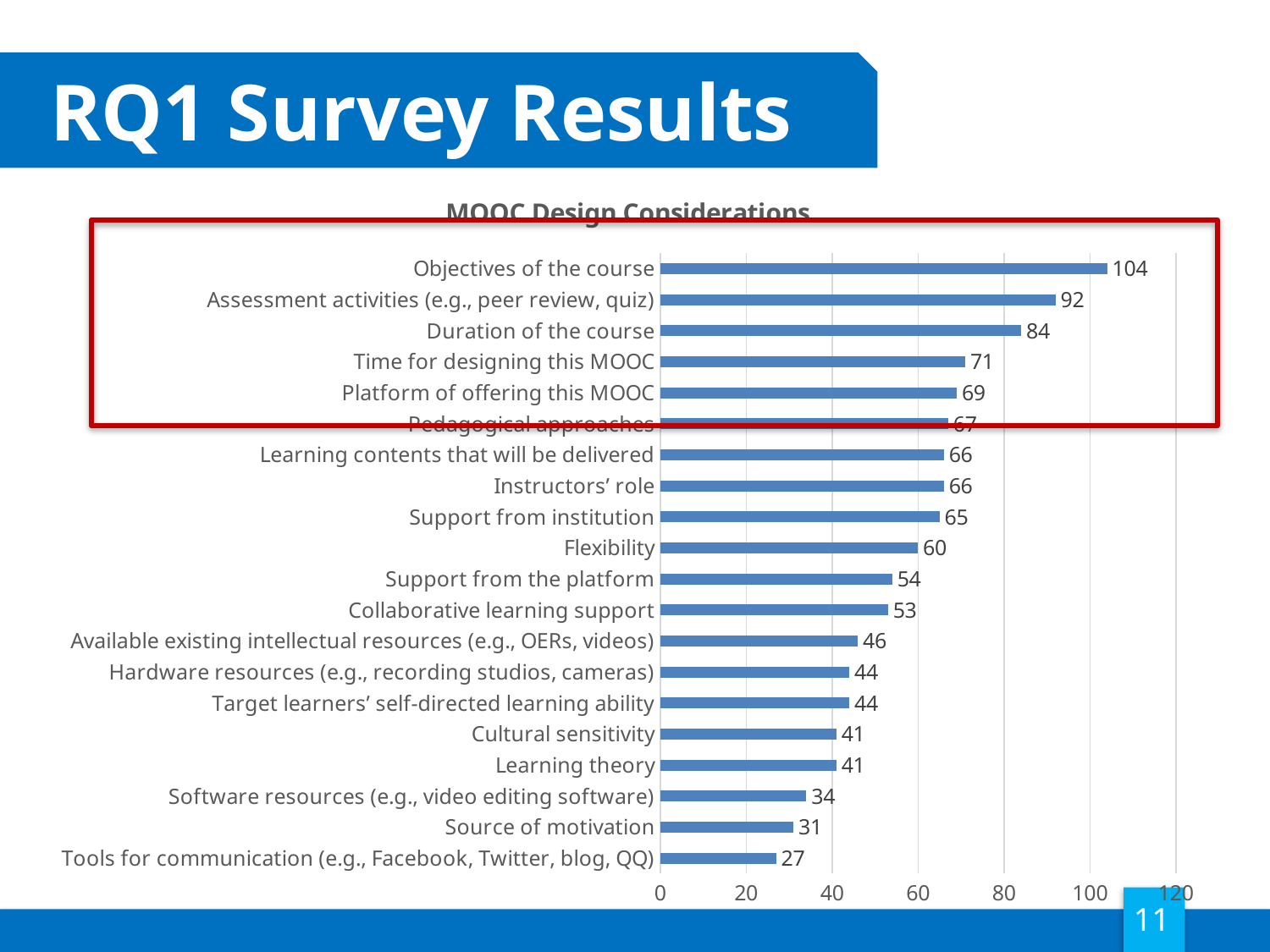
What is the value for Objectives of the course? 104 How many categories are shown in the chart? 20 What is the difference between the values for Objectives of the course and Assessment activities (e.g., peer review, quiz)? 12 What is the value for Duration of the course? 84 Which is larger, the value for Time for designing this MOOC or the value for Support from the platform? Time for designing this MOOC What kind of chart is shown on the slide? bar chart Which category has the highest value? Objectives of the course Is the value for Cultural sensitivity greater or less than 60? less What is the value for Flexibility? 60 What is the title of the chart? MOOC Design Considerations What is the value for Source of motivation? 31 Which category has the lowest value? Tools for communication (e.g., Facebook, Twitter, blog, QQ)